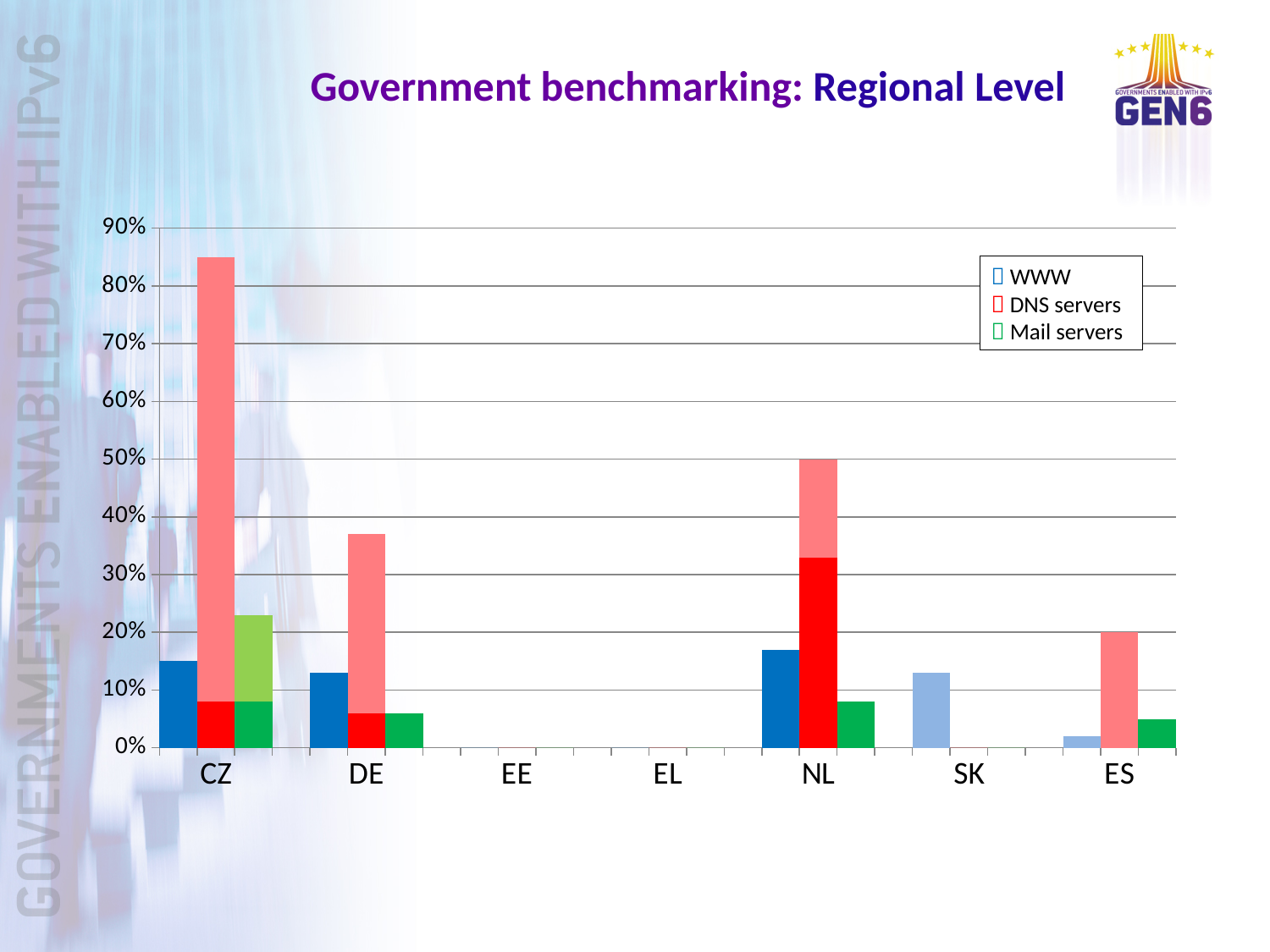
How many countries are shown on the x axis? 7 Which country has the highest DNS servers value? CZ How many series does the legend list? 3 Is the DNS servers value for CZ greater or less than 80%? greater Which is larger, the WWW value for NL or the WWW value for DE? NL What kind of chart is shown on the slide? bar chart What is the title of the slide containing the chart? Government benchmarking: Regional Level Is the WWW value for NL greater or less than 20%? less Is the Mail servers value for CZ greater or less than 20%? greater Which country has the highest WWW value? NL What are the three series named in the legend? WWW, DNS servers, Mail servers